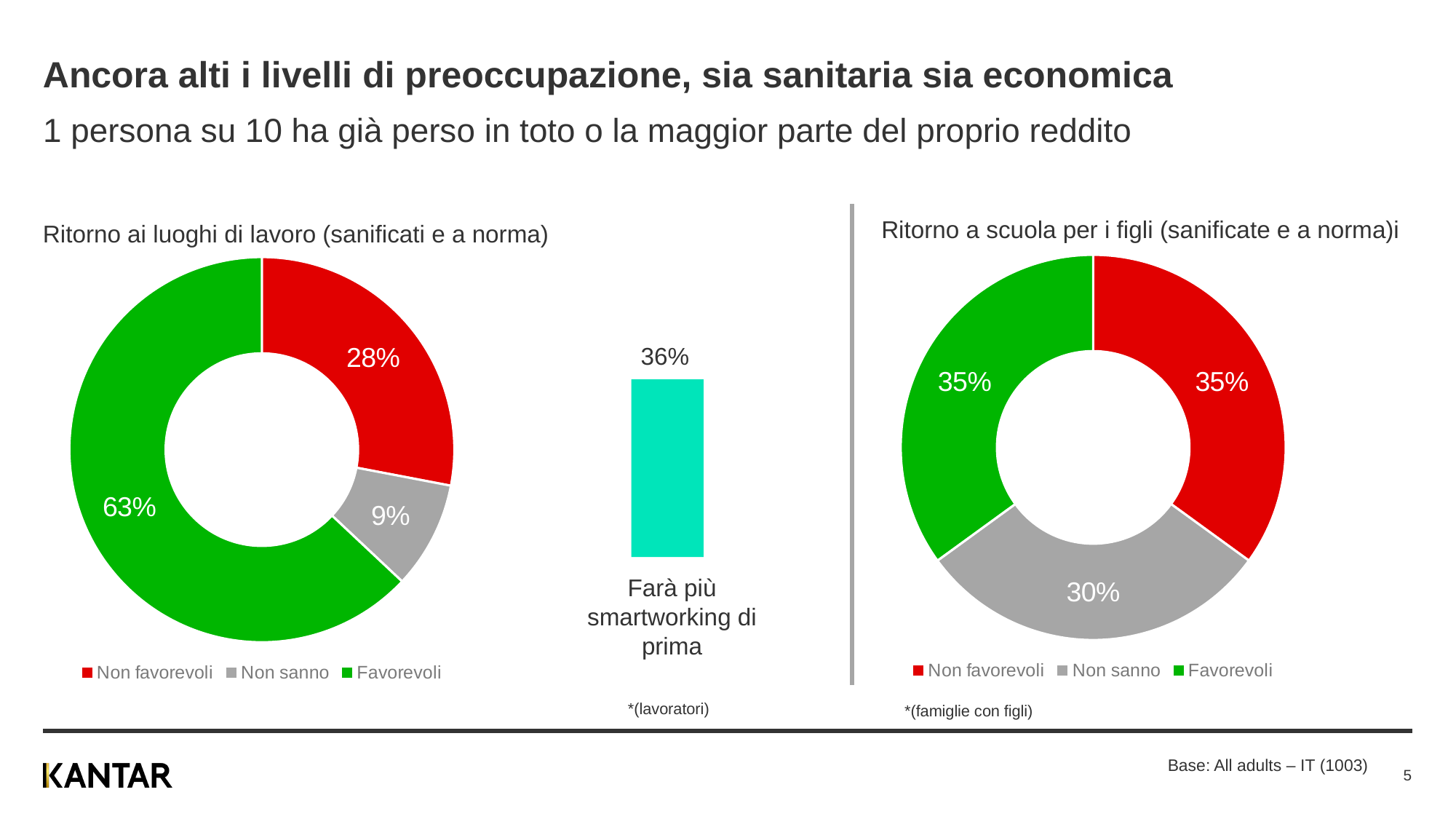
What value is shown on the bar in the middle chart labelled "Farà più smartworking di prima"? 36% In the chart titled "Ritorno a scuola per i figli (sanificate e a norma)", what percentage is Non favorevoli? 35% What kind of chart is the middle chart labelled "Farà più smartworking di prima"? Bar chart In the chart titled "Ritorno a scuola per i figli (sanificate e a norma)", what percentage is Non sanno? 30% In the chart titled "Ritorno ai luoghi di lavoro (sanificati e a norma)", which category has the smallest share? Non sanno In the chart titled "Ritorno ai luoghi di lavoro (sanificati e a norma)", what percentage is Non sanno? 9% In the chart titled "Ritorno ai luoghi di lavoro (sanificati e a norma)", which colour represents Non favorevoli? Red In the chart titled "Ritorno ai luoghi di lavoro (sanificati e a norma)", what is the difference in percentage points between Favorevoli and Non favorevoli? 35 In the chart titled "Ritorno ai luoghi di lavoro (sanificati e a norma)", what percentage is Favorevoli? 63% In the chart titled "Ritorno a scuola per i figli (sanificate e a norma)", how many categories does the legend list? 3 In the chart titled "Ritorno ai luoghi di lavoro (sanificati e a norma)", which category has the largest share? Favorevoli In the chart titled "Ritorno a scuola per i figli (sanificate e a norma)", which category has the smallest share? Non sanno